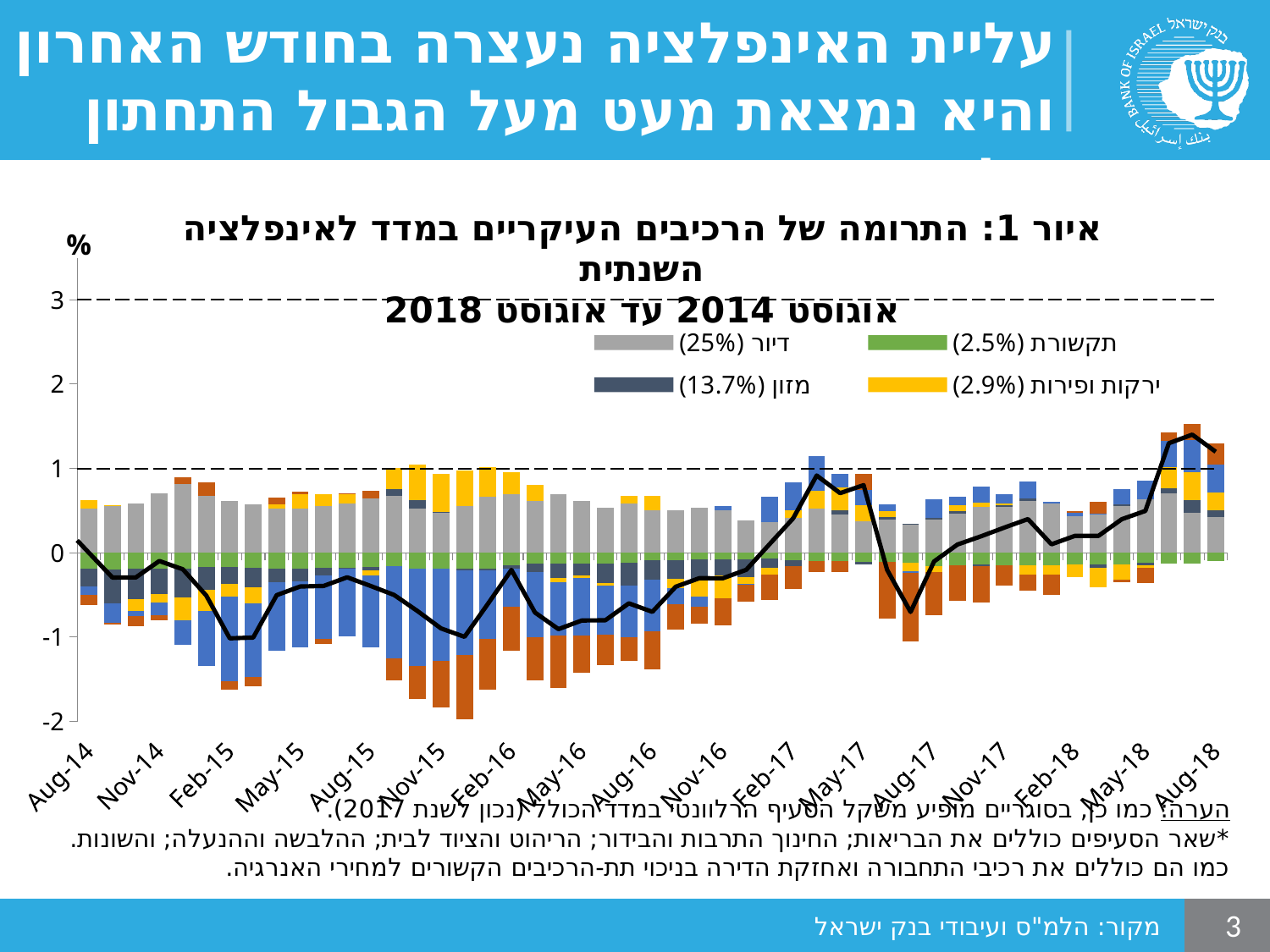
How many series are listed in the visible legend of the chart? 4 What unit is shown at the top of the y axis? % What is the highest value shown on the y axis? 3 Is the value of the black line at Nov-16 greater or less than 0? less Does the black line rise or fall between Aug-14 and Feb-15? Falls What kind of chart is shown on the slide? A stacked bar chart with a line overlay Is the highest value reached by the black line greater or less than 1? greater Is the value of the black line at May-18 greater or less than 1? less Does the black line rise or fall between Feb-18 and Aug-18? Rises Which colour represents דיור (25%) in the legend? Gray